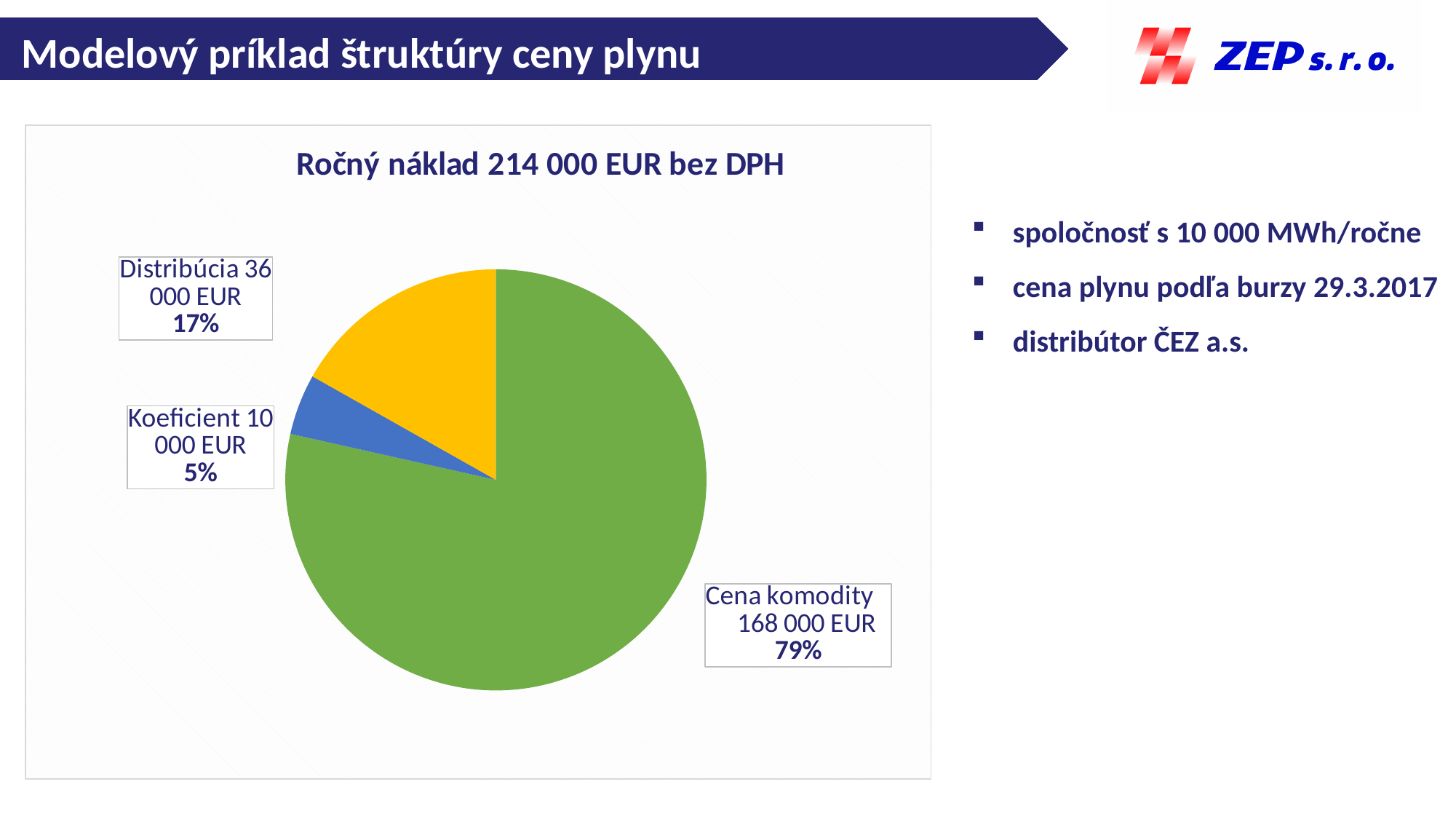
Which category has the largest slice? Cena komodity What is the value for Cena komodity? 168 000 EUR What is the title of the chart? Ročný náklad 214 000 EUR bez DPH What type of chart is shown on the slide? pie chart What is the value for Distribúcia? 36 000 EUR What share of the pie does Distribúcia represent? 17% Which colour is used for the Distribúcia slice? yellow Which category has the smallest slice? Koeficient What share of the pie does Cena komodity represent? 79% What is the difference between the values for Cena komodity and Distribúcia? 132 000 EUR What is the value for Koeficient? 10 000 EUR How many slices does the pie chart have? 3